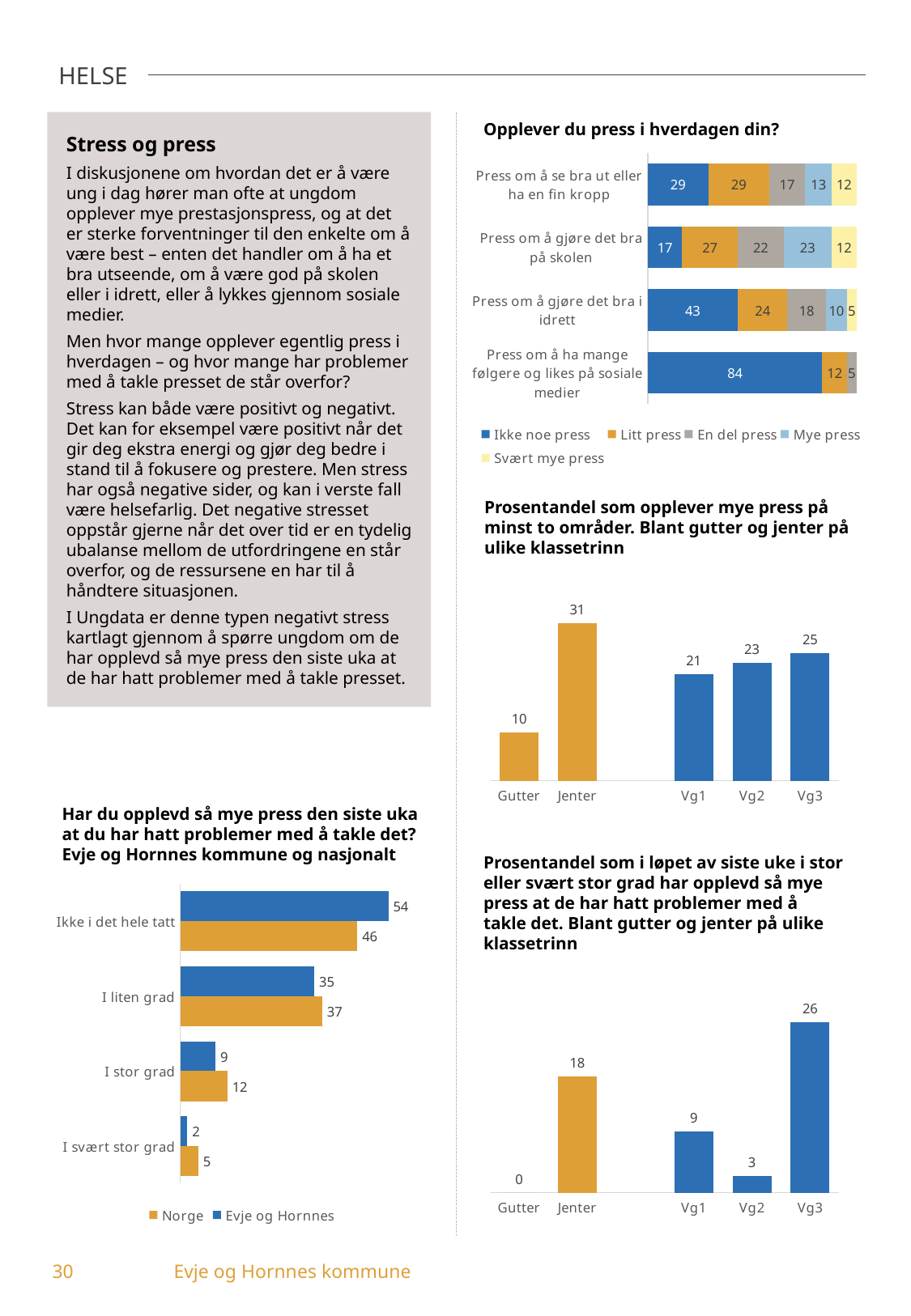
In the chart 'Har du opplevd så mye press den siste uka at du har hatt problemer med å takle det?', which is larger for 'Ikke i det hele tatt': Norge or Evje og Hornnes? Evje og Hornnes In the chart 'Har du opplevd så mye press den siste uka at du har hatt problemer med å takle det?', what is the value for Norge in the category 'I stor grad'? 12 In the chart 'Prosentandel som opplever mye press på minst to områder', what is the difference between the values for Jenter and Gutter? 21 In the chart 'Opplever du press i hverdagen din?', what is the value for 'Ikke noe press' in the category 'Press om å ha mange følgere og likes på sosiale medier'? 84 In the chart 'Har du opplevd så mye press den siste uka at du har hatt problemer med å takle det?', what kind of chart is it? Bar chart In the chart 'Prosentandel som i løpet av siste uke i stor eller svært stor grad har opplevd så mye press', what is the value for Vg3? 26 In the chart 'Prosentandel som opplever mye press på minst to områder', which category has the highest value? Jenter In the chart 'Opplever du press i hverdagen din?', what is the total of the stacked bar for 'Press om å gjøre det bra i idrett'? 100 In the chart 'Opplever du press i hverdagen din?', how many series does the legend list? 5 In the chart 'Prosentandel som opplever mye press på minst to områder', how many categories are plotted? 5 In the chart 'Prosentandel som i løpet av siste uke i stor eller svært stor grad har opplevd så mye press', which category has the lowest value? Gutter In the chart 'Opplever du press i hverdagen din?', what is the value for 'Litt press' in the category 'Press om å gjøre det bra på skolen'? 27